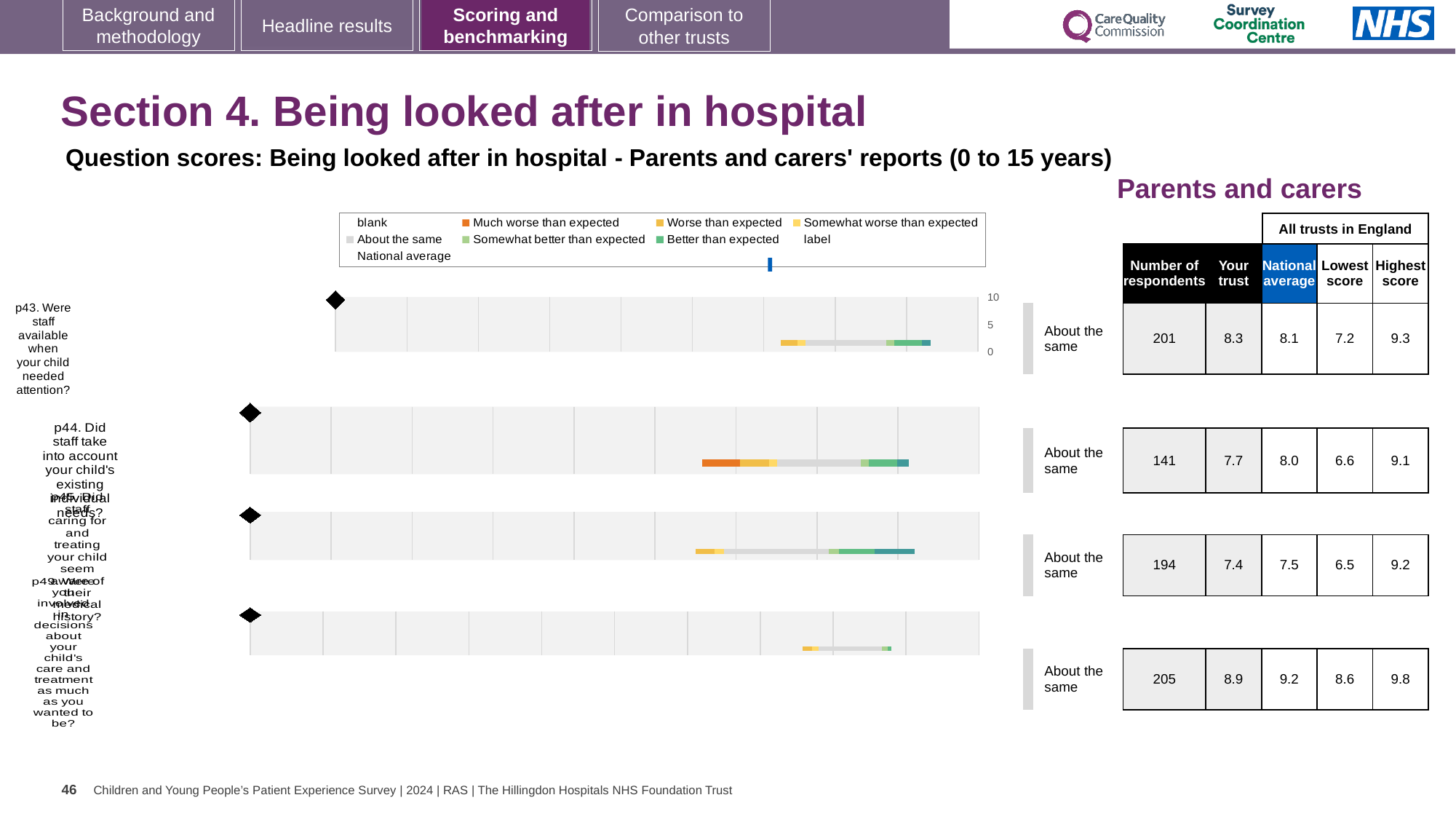
Which question has the lowest 'Your trust' score? p45 For p43, what is the difference between the highest score and the lowest score across all trusts in England? 2.1 Which question has the highest 'Your trust' score? p49 How many respondents answered p49? 205 What is the national average score for p44? 8.0 What kind of chart is used to show the question scores on this slide? bar chart What is the lowest score across all trusts in England for p45? 6.5 What is the 'Your trust' score for p43 (Were staff available when your child needed attention?)? 8.3 For p44, which is larger: the 'Your trust' score or the national average? National average What benchmark category is shown for p43? About the same What heading appears above the results table on the right of the chart? Parents and carers How many questions (rows) are plotted in the chart? 4